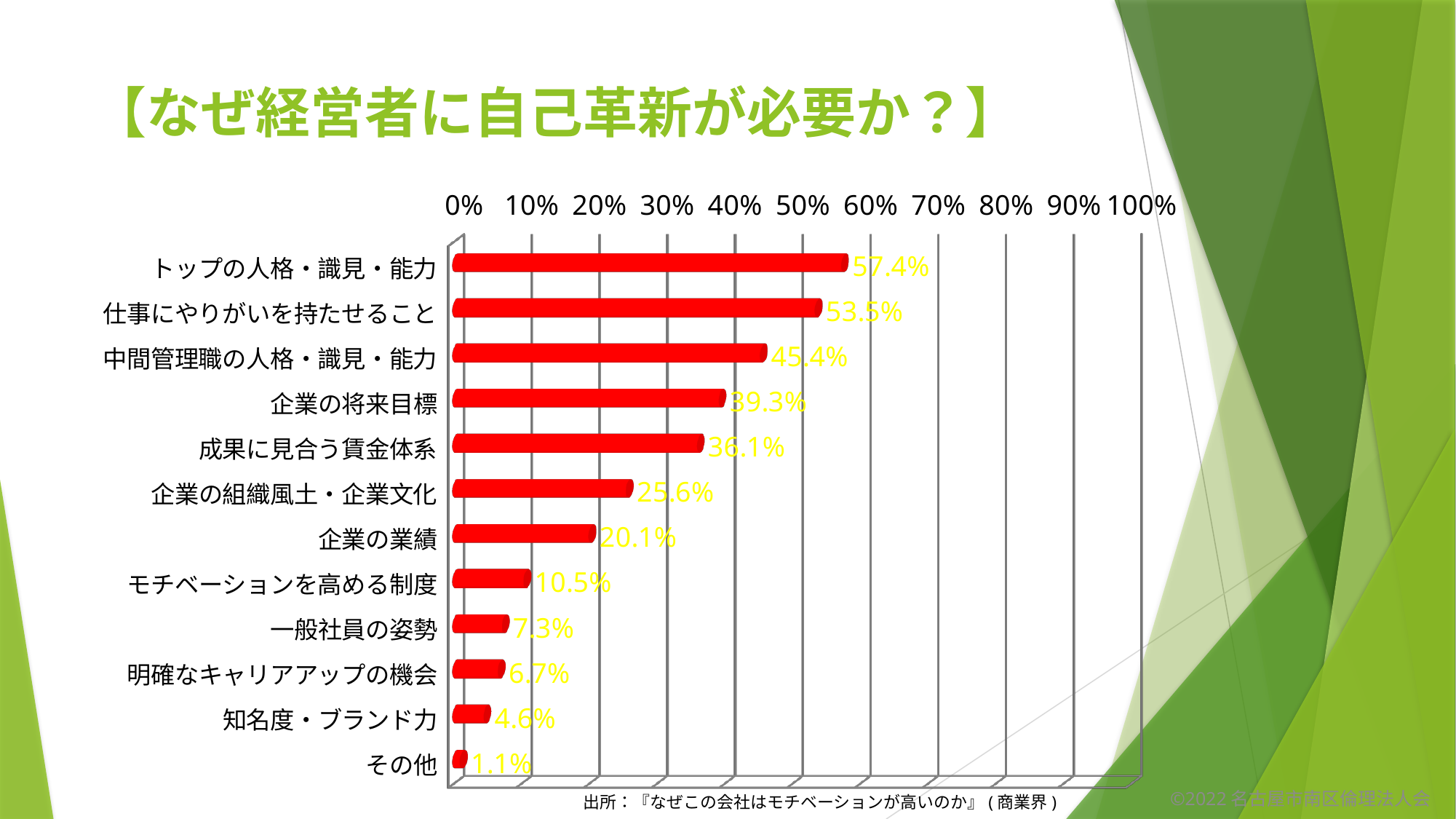
How many categories are shown in the chart? 12 What colour are the bars in the chart? red What kind of chart is shown on the slide? bar chart What is the difference between 一般社員の姿勢 and 明確なキャリアアップの機会? 0.6% What is the value for モチベーションを高める制度? 10.5% What is the value for 企業の将来目標? 39.3% Which is larger, 成果に見合う賃金体系 or 企業の組織風土・企業文化? 成果に見合う賃金体系 Which category has the highest value? トップの人格・識見・能力 Which category has the lowest value? その他 Is the value for 企業の業績 greater or less than 30%? less What is the value for トップの人格・識見・能力? 57.4% What is the difference between 仕事にやりがいを持たせること and 中間管理職の人格・識見・能力? 8.1%